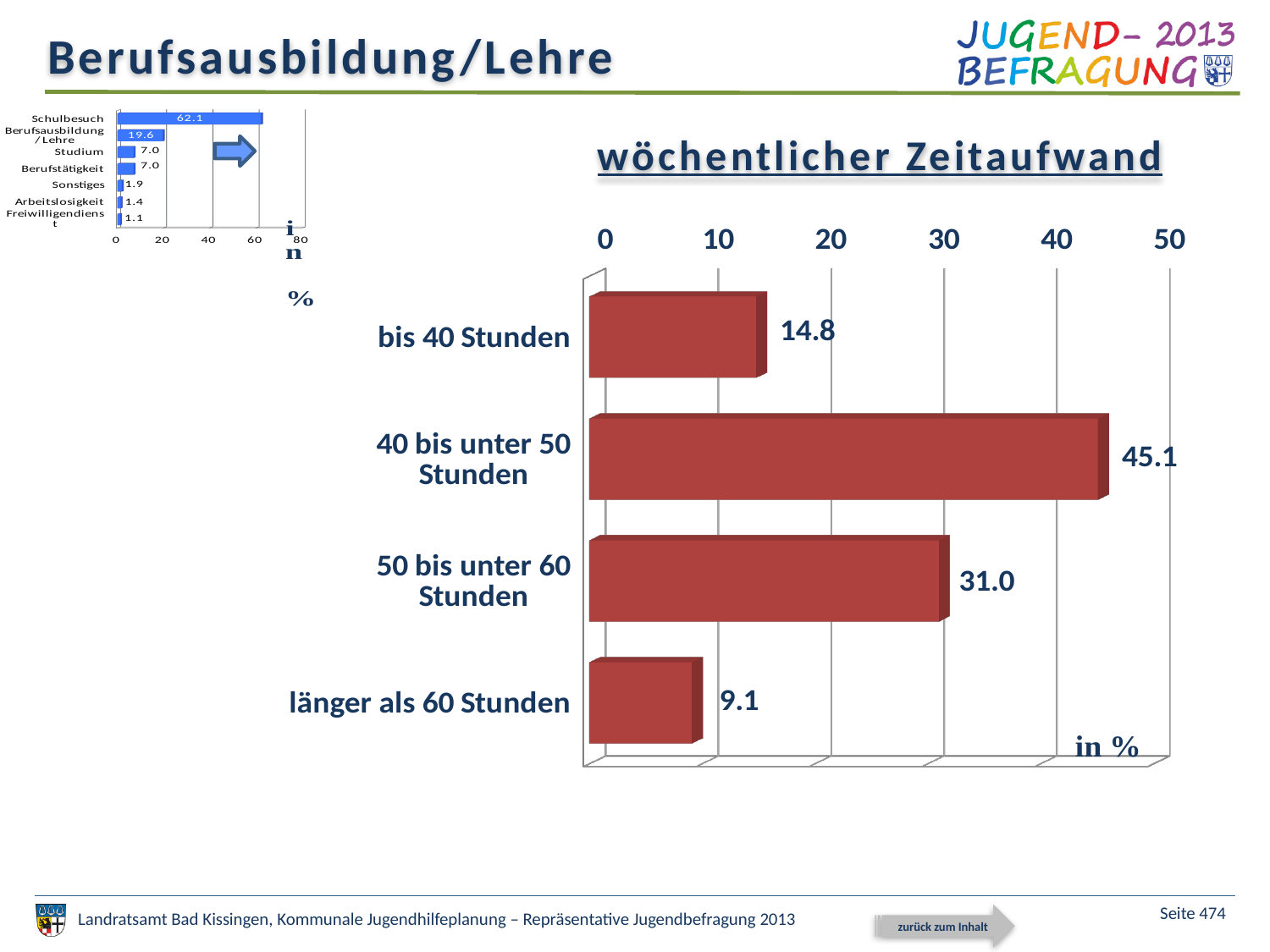
In the small chart at the top left of the slide, what is the value for 'Berufsausbildung/Lehre'? 19.6 In the small chart at the top left of the slide, what is the value for 'Schulbesuch'? 62.1 In the 'wöchentlicher Zeitaufwand' chart, what is the value for 'länger als 60 Stunden'? 9.1 In the 'wöchentlicher Zeitaufwand' chart, which category has the highest value? 40 bis unter 50 Stunden In the small chart at the top left of the slide, how many categories are shown? 7 In the 'wöchentlicher Zeitaufwand' chart, how many categories are shown? 4 In the small chart at the top left of the slide, which category has the highest value? Schulbesuch In the 'wöchentlicher Zeitaufwand' chart, what is the value for '40 bis unter 50 Stunden'? 45.1 In the 'wöchentlicher Zeitaufwand' chart, what is the difference between '50 bis unter 60 Stunden' and 'bis 40 Stunden'? 16.2 What kind of chart is the 'wöchentlicher Zeitaufwand' chart? bar chart In the 'wöchentlicher Zeitaufwand' chart, which is larger: 'bis 40 Stunden' or 'länger als 60 Stunden'? bis 40 Stunden In the 'wöchentlicher Zeitaufwand' chart, which category has the lowest value? länger als 60 Stunden